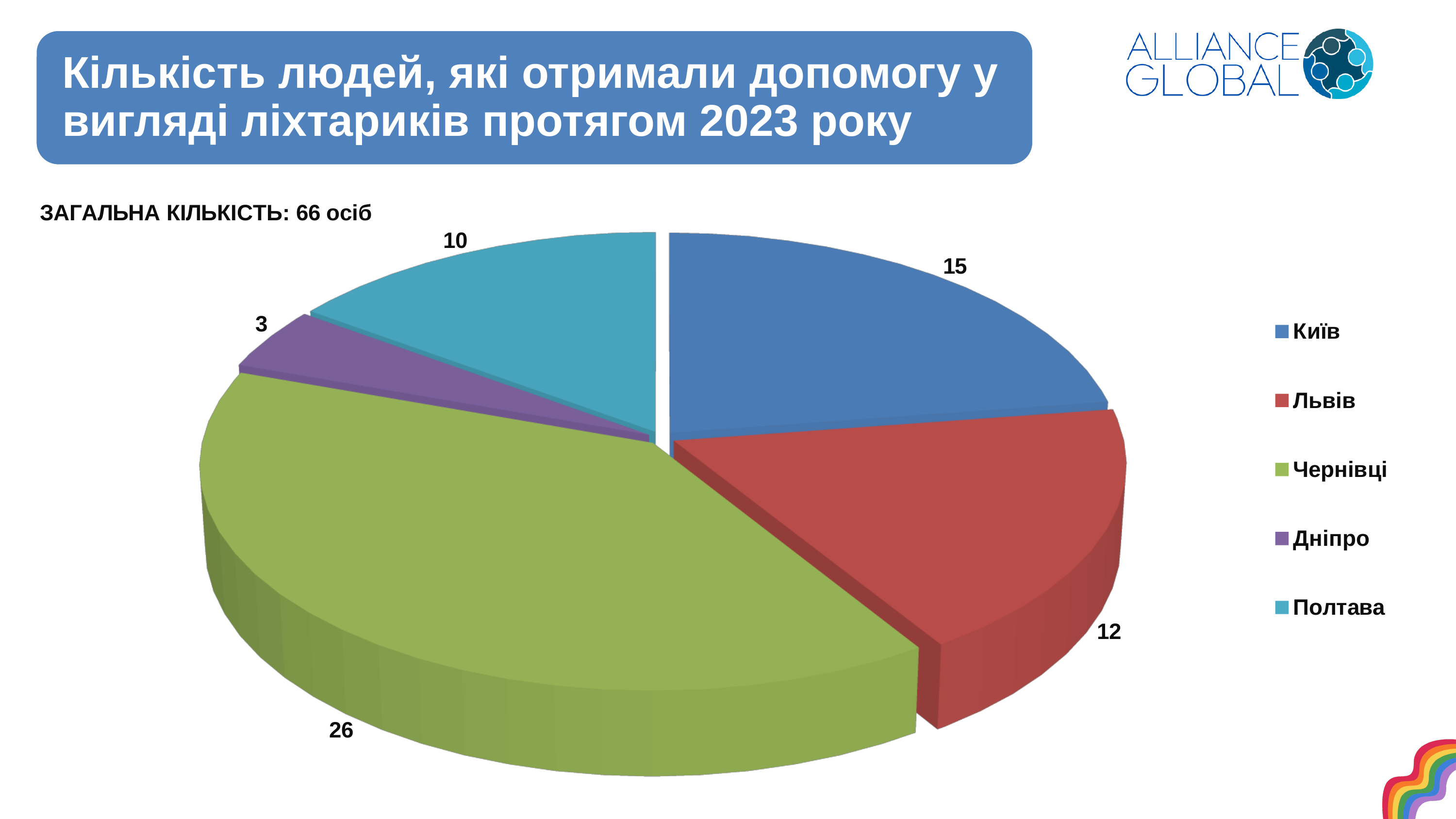
What is the value for Дніпро? 3 What is the value for Полтава? 10 What type of chart is shown on the slide? pie chart How many cities are shown in the pie chart? 5 What total number of people is stated above the chart? 66 осіб What is the difference between the values for Чернівці and Київ? 11 What is the value for Львів? 12 What is the value for Чернівці? 26 Which is larger, the value for Київ or the value for Полтава? Київ Which city has the smallest slice of the pie? Дніпро How many people received flashlights in Київ? 15 Which city has the largest slice of the pie? Чернівці